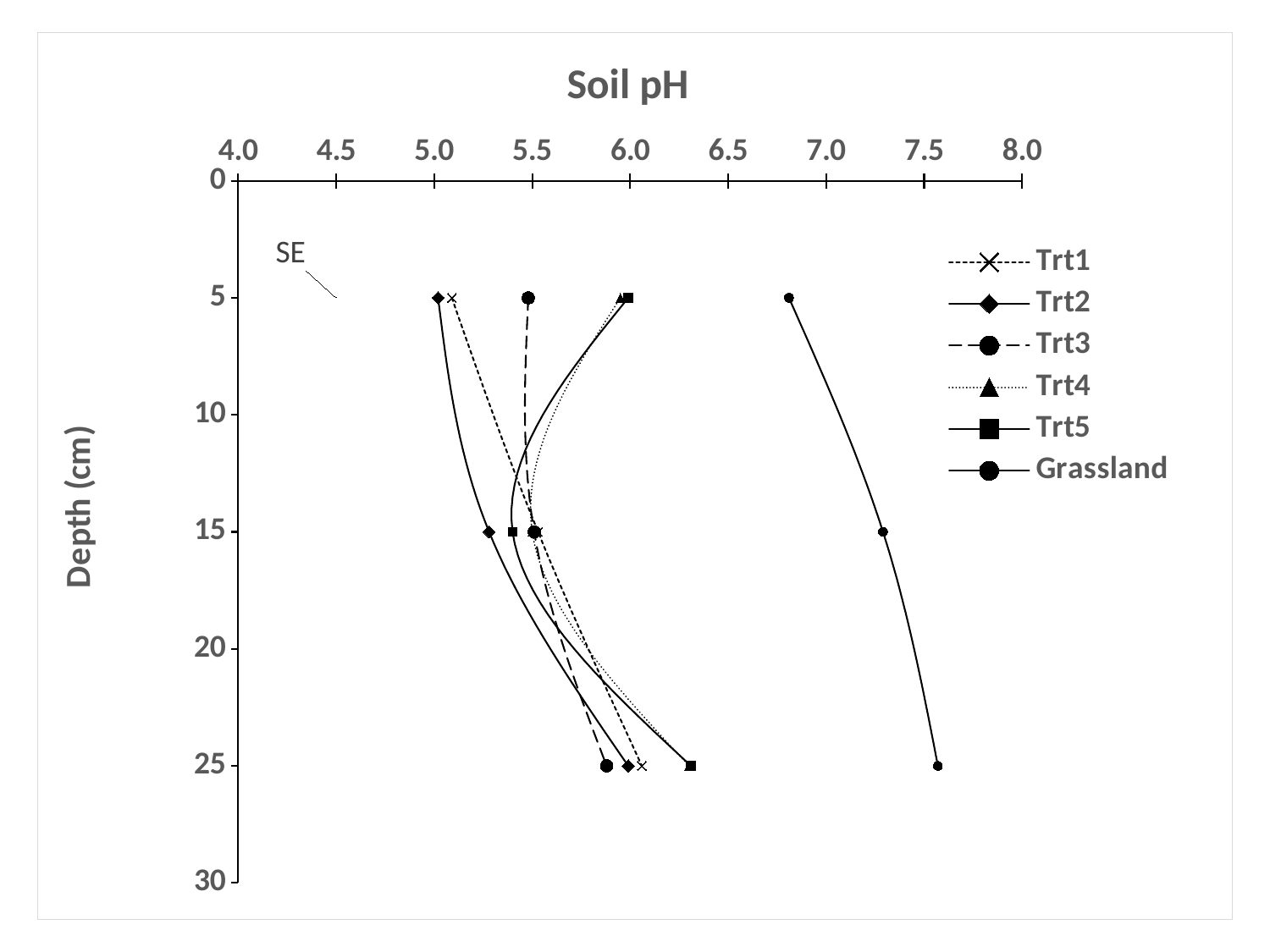
How many series does the legend list? 6 Is the soil pH for Grassland at 25 cm depth greater or less than 7.0? greater What is the title of the vertical axis? Depth (cm) Does the soil pH for Grassland rise or fall as depth increases from 5 cm to 25 cm? rise Which series has the highest soil pH at a depth of 5 cm? Grassland Is the soil pH for Grassland at 5 cm depth greater or less than 6.5? greater Which series has the lowest soil pH at a depth of 5 cm? Trt2 At how many depths are data points plotted for each series? 3 Is the soil pH for Trt2 at 5 cm depth greater or less than 5.5? less At 25 cm depth, which has the higher soil pH, Grassland or Trt5? Grassland What kind of chart is shown on the slide? line chart